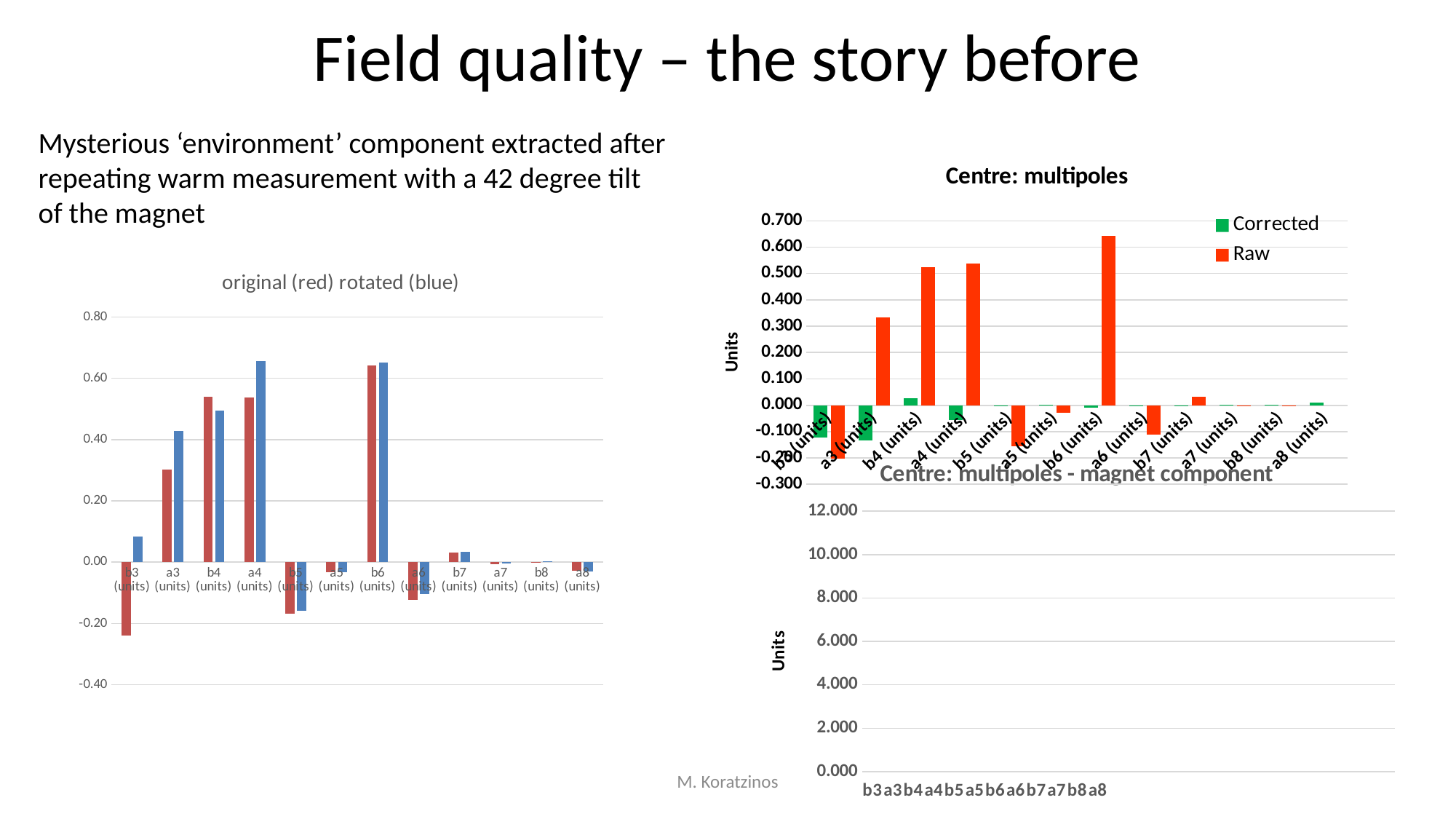
In the 'Centre: multipoles' chart, which category has the lowest Raw value? b3 (units) In the 'original (red) rotated (blue)' chart, is the blue (rotated) value for a3 (units) greater or less than 0.40? greater In the 'original (red) rotated (blue)' chart, is the red (original) value for b3 (units) greater or less than -0.20? less In the 'Centre: multipoles' chart, is the Raw value for a4 (units) greater or less than 0.500? greater In the 'original (red) rotated (blue)' chart, which category has the highest red (original) bar? b6 (units) In the 'original (red) rotated (blue)' chart, which is larger: the red (original) bar for b4 (units) or the red (original) bar for a3 (units)? b4 (units) In the 'Centre: multipoles' chart, what are the two series named in the legend? Corrected and Raw In the 'Centre: multipoles' chart, which category has the highest Raw value? b6 (units) In the 'original (red) rotated (blue)' chart, which category has the lowest red (original) bar? b3 (units) In the 'Centre: multipoles' chart, how many series does the legend list? 2 What kind of chart is the 'original (red) rotated (blue)' chart on the left? bar chart In the 'original (red) rotated (blue)' chart, how many categories are shown on the x axis? 12